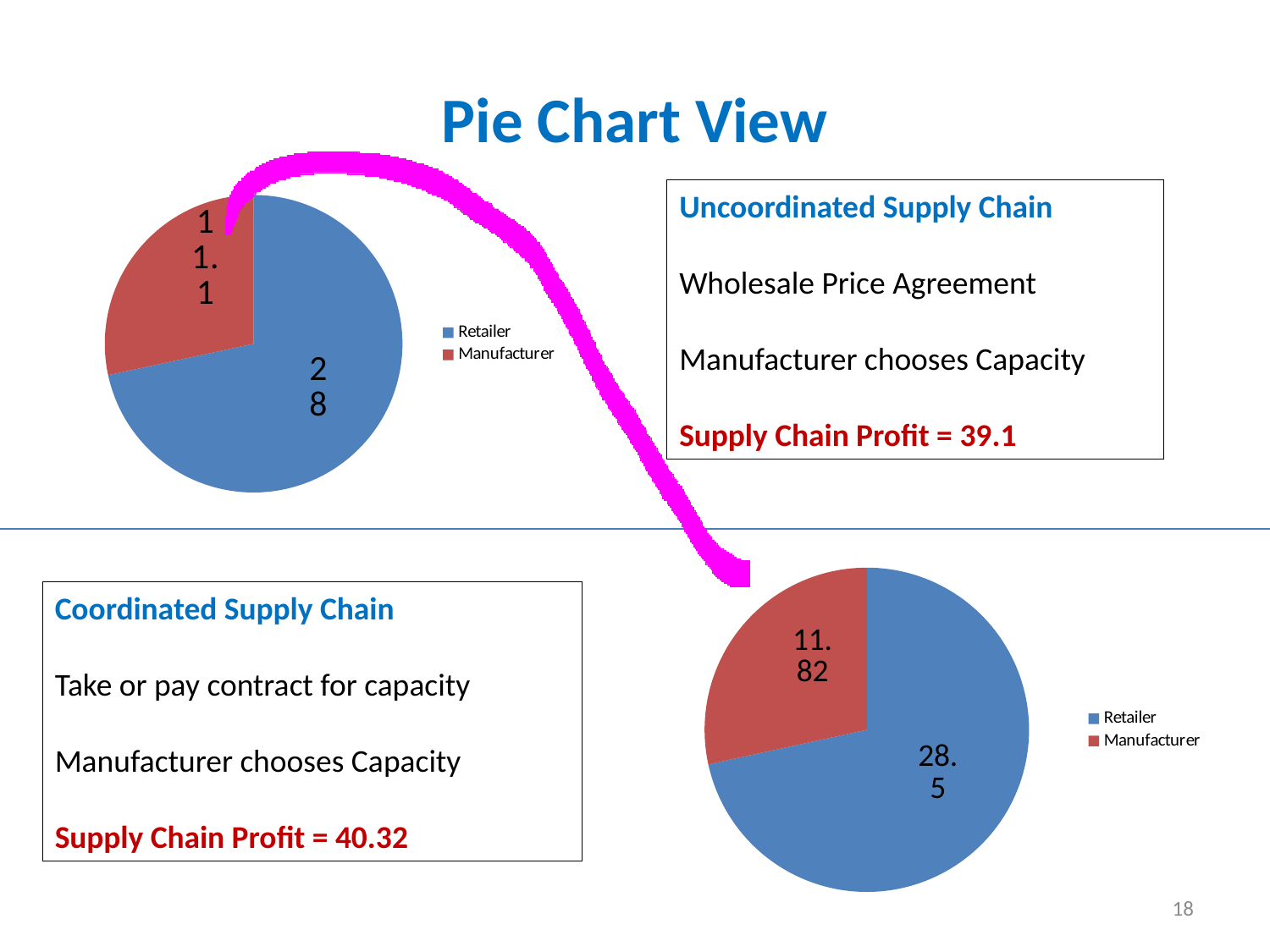
How many slices does the bottom-right pie chart have? 2 Is the Retailer value larger in the top-left pie chart or the bottom-right pie chart? bottom-right pie chart In the top-left pie chart, what is the difference between the Retailer and Manufacturer values? 16.9 In the top-left pie chart, which slice is the largest? Retailer In the bottom-right pie chart, what is the value for Retailer? 28.5 In the top-left pie chart, what is the value for Manufacturer? 11.1 In the bottom-right pie chart, what is the value for Manufacturer? 11.82 In the bottom-right pie chart, what is the difference between the Retailer and Manufacturer values? 16.68 In the bottom-right pie chart, what colour is the Manufacturer slice? red In the bottom-right pie chart, which slice is the smallest? Manufacturer What type of chart is shown in the top-left of the slide? pie chart In the top-left pie chart, what is the value for Retailer? 28